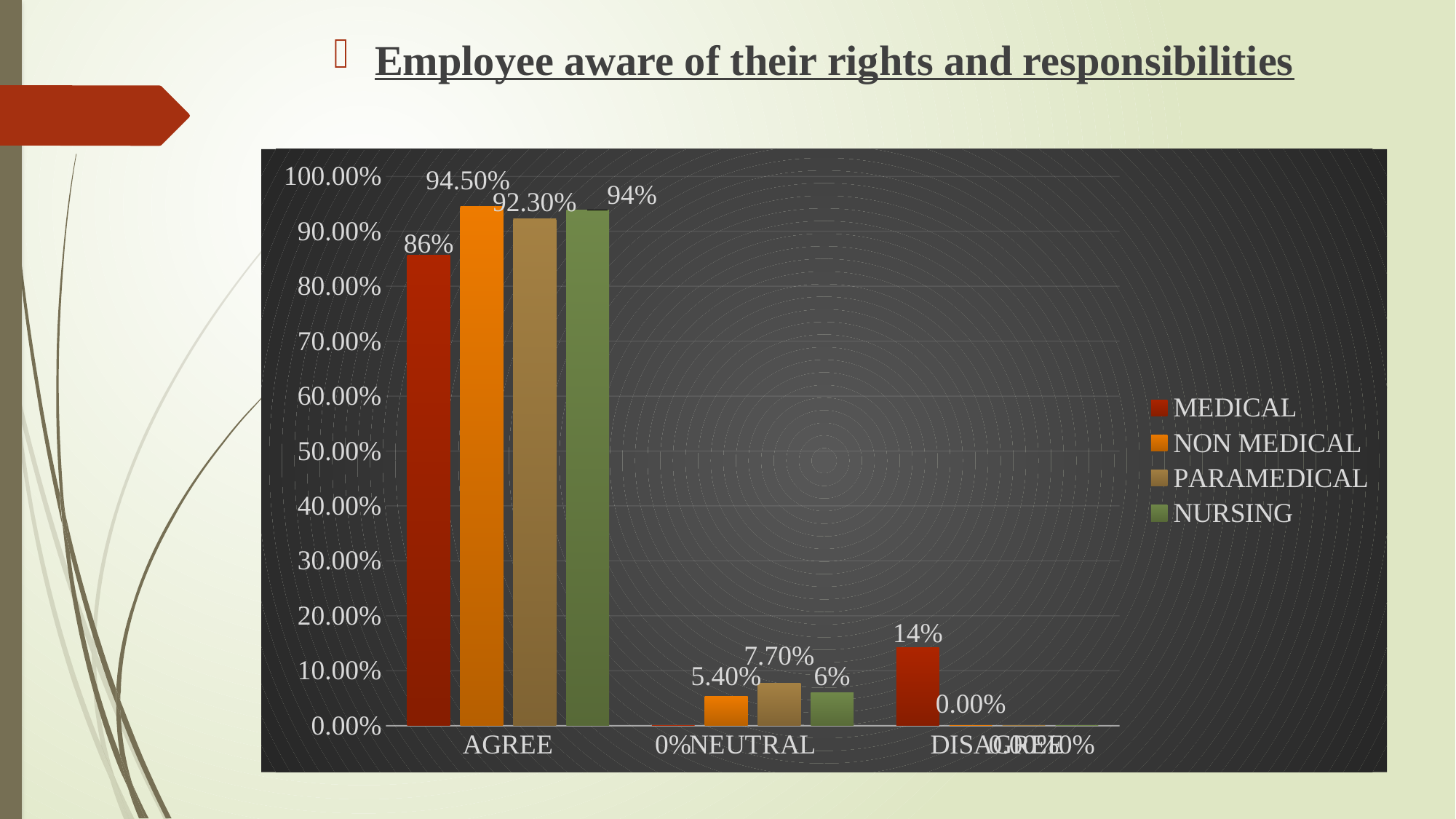
How many categories are shown on the x axis? 3 What kind of chart is shown on the slide? Bar chart What is the difference between the NON MEDICAL and MEDICAL values in the AGREE category? 8.50% What is the value for NURSING in the AGREE category? 94% What is the value for PARAMEDICAL in the AGREE category? 92.30% What is the value for PARAMEDICAL in the NEUTRAL category? 7.70% In the NEUTRAL category, which is larger: PARAMEDICAL or NURSING? PARAMEDICAL How many series does the legend list? 4 What is the value for MEDICAL in the DISAGREE category? 14% What is the value for MEDICAL in the AGREE category? 86% Which series has the lowest value in the AGREE category? MEDICAL What is the value for NON MEDICAL in the AGREE category? 94.50%